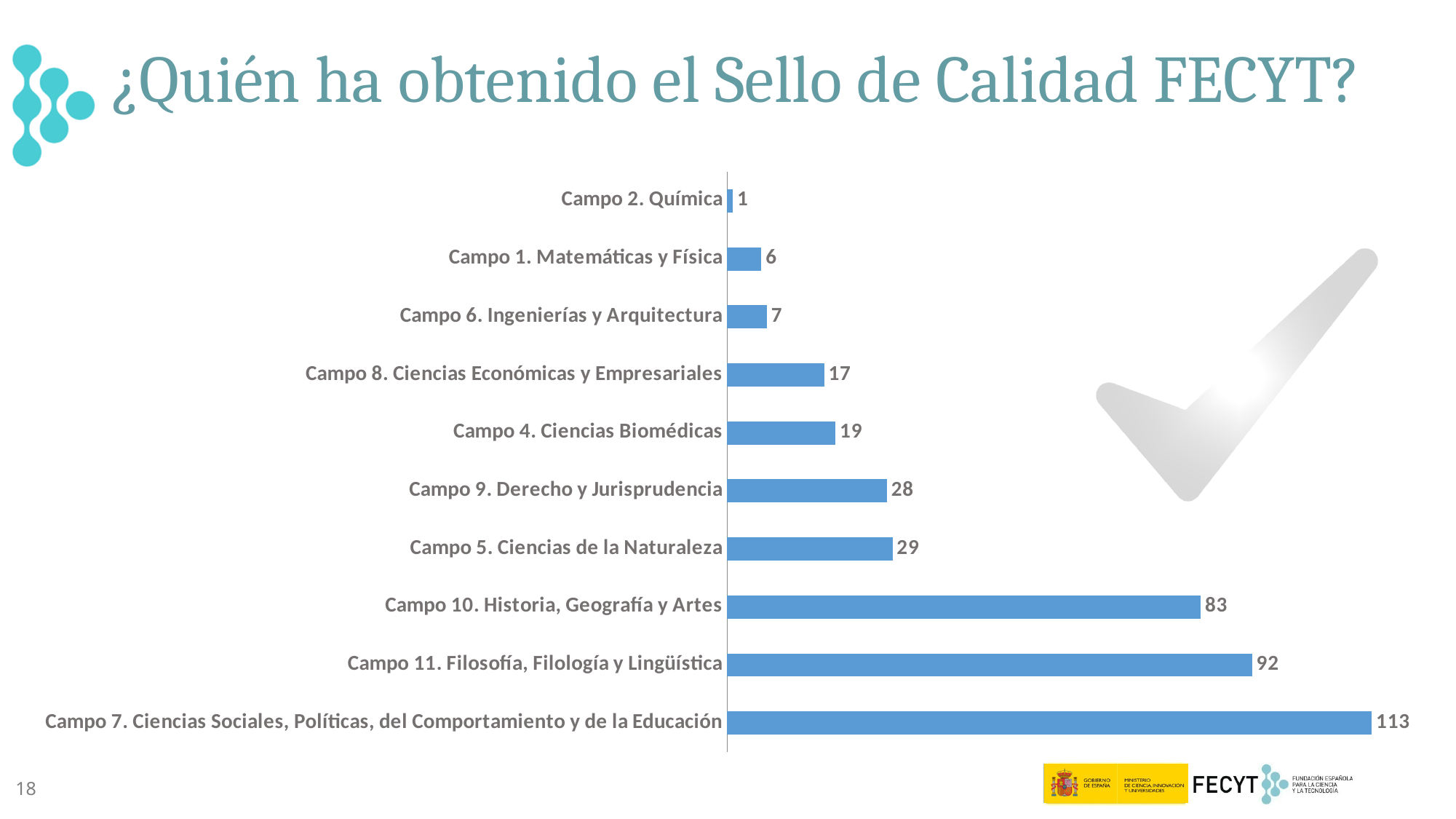
What is the difference between the values for Campo 11. Filosofía, Filología y Lingüística and Campo 10. Historia, Geografía y Artes? 9 What is the value for Campo 4. Ciencias Biomédicas? 19 What is the difference between the values for Campo 9. Derecho y Jurisprudencia and Campo 8. Ciencias Económicas y Empresariales? 11 Which category has the lowest value? Campo 2. Química What colour are the bars in the chart? Blue Which is larger, the value for Campo 5. Ciencias de la Naturaleza or Campo 6. Ingenierías y Arquitectura? Campo 5. Ciencias de la Naturaleza What is the value for Campo 7. Ciencias Sociales, Políticas, del Comportamiento y de la Educación? 113 What kind of chart is shown on the slide? Bar chart How many categories are shown in the chart? 10 What is the title of the slide containing the chart? ¿Quién ha obtenido el Sello de Calidad FECYT? What is the value for Campo 1. Matemáticas y Física? 6 Which category has the highest value? Campo 7. Ciencias Sociales, Políticas, del Comportamiento y de la Educación